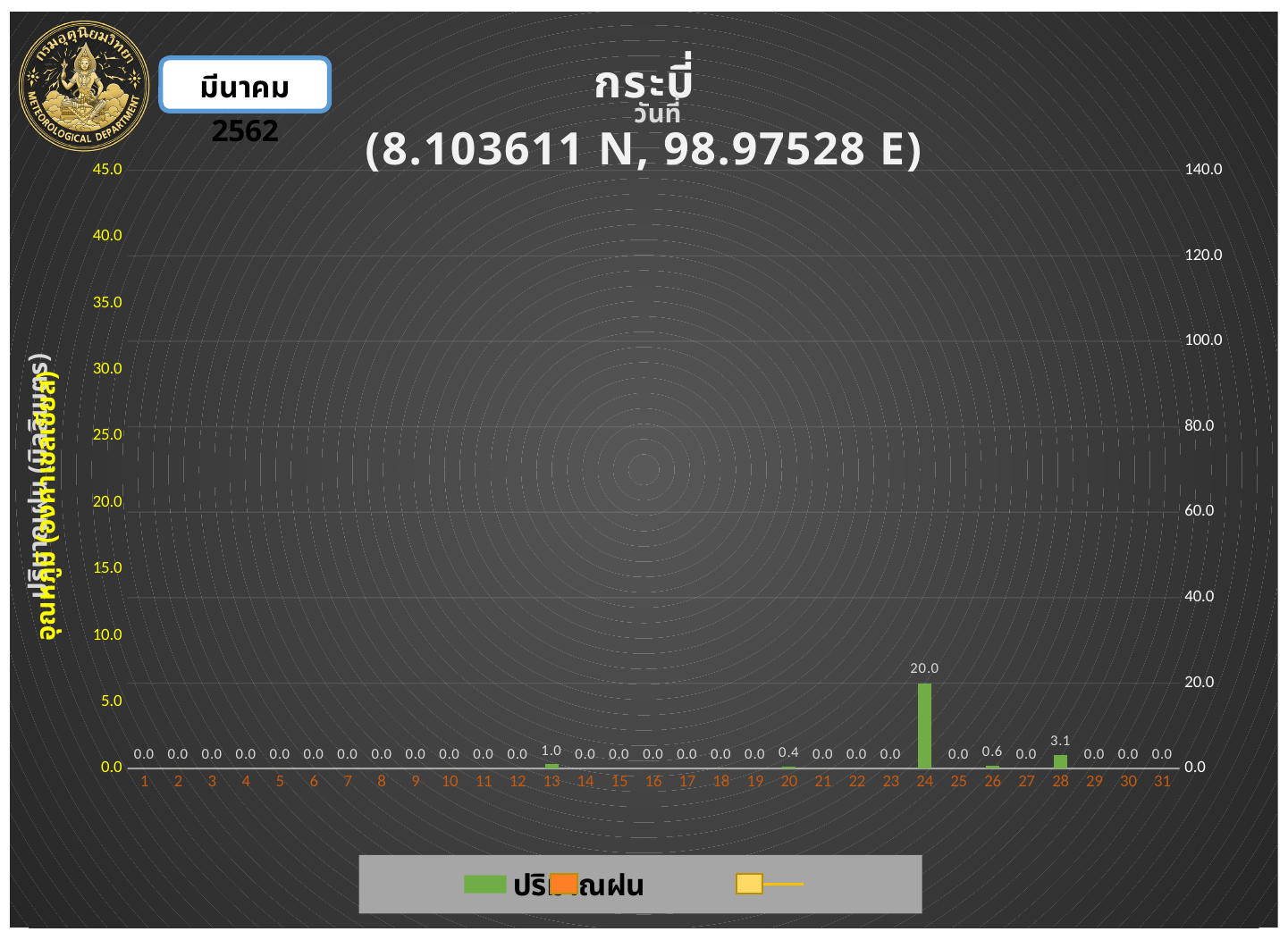
What is the rainfall value shown for day 24? 20.0 How many days are shown on the x axis of the chart? 31 What is the rainfall value shown for day 28? 3.1 What is the rainfall value shown for day 26? 0.6 What is the difference between the rainfall values for day 24 and day 28? 16.9 What is the difference between the rainfall values for day 28 and day 13? 2.1 Which day has the larger rainfall value, day 13 or day 28? 28 What is the rainfall value shown for day 13? 1.0 What kind of chart is shown on the slide? bar chart What is the rainfall value shown for day 20? 0.4 What is the rainfall value shown for day 1? 0.0 Which day has the highest rainfall value? 24